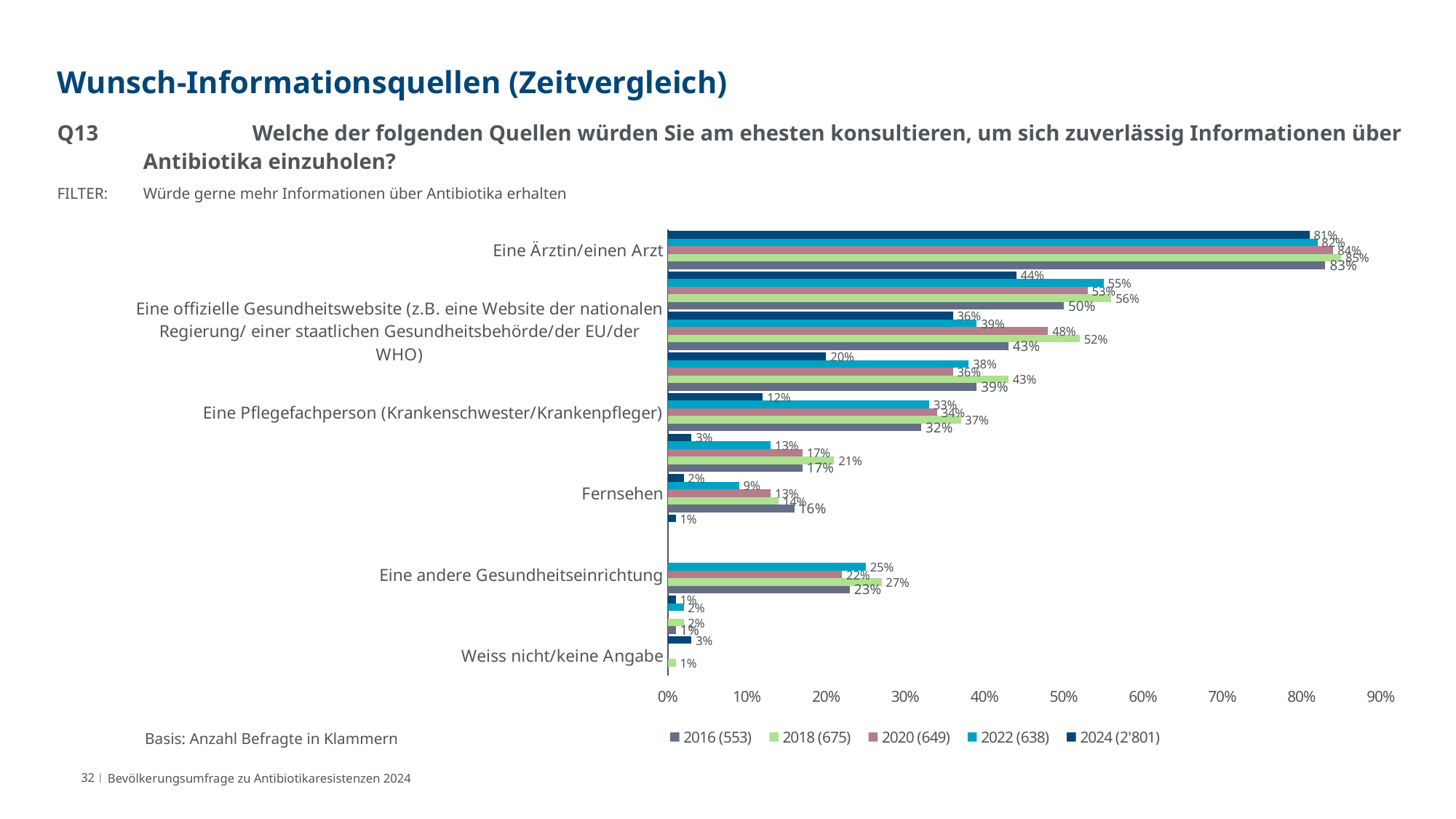
What is the highest tick label shown on the x axis? 90% Is the 2020 value for "Eine Ärztin/einen Arzt" greater or less than 80%? greater For "Eine Ärztin/einen Arzt", which is larger: the 2016 value or the 2022 value? 2016 What is the 2016 value for "Eine Ärztin/einen Arzt"? 83% What is the difference between the 2018 and 2024 values for "Eine Ärztin/einen Arzt"? 4 percentage points How many series does the legend list? 5 What is the legend entry for the 2024 series? 2024 (2'801) What is the 2018 value for "Eine Ärztin/einen Arzt"? 85% Which year has the highest value for "Eine Ärztin/einen Arzt"? 2018 Which year has the lowest value for "Eine Ärztin/einen Arzt"? 2024 What is the 2024 value for "Eine Ärztin/einen Arzt"? 81% What kind of chart is shown on the slide? bar chart